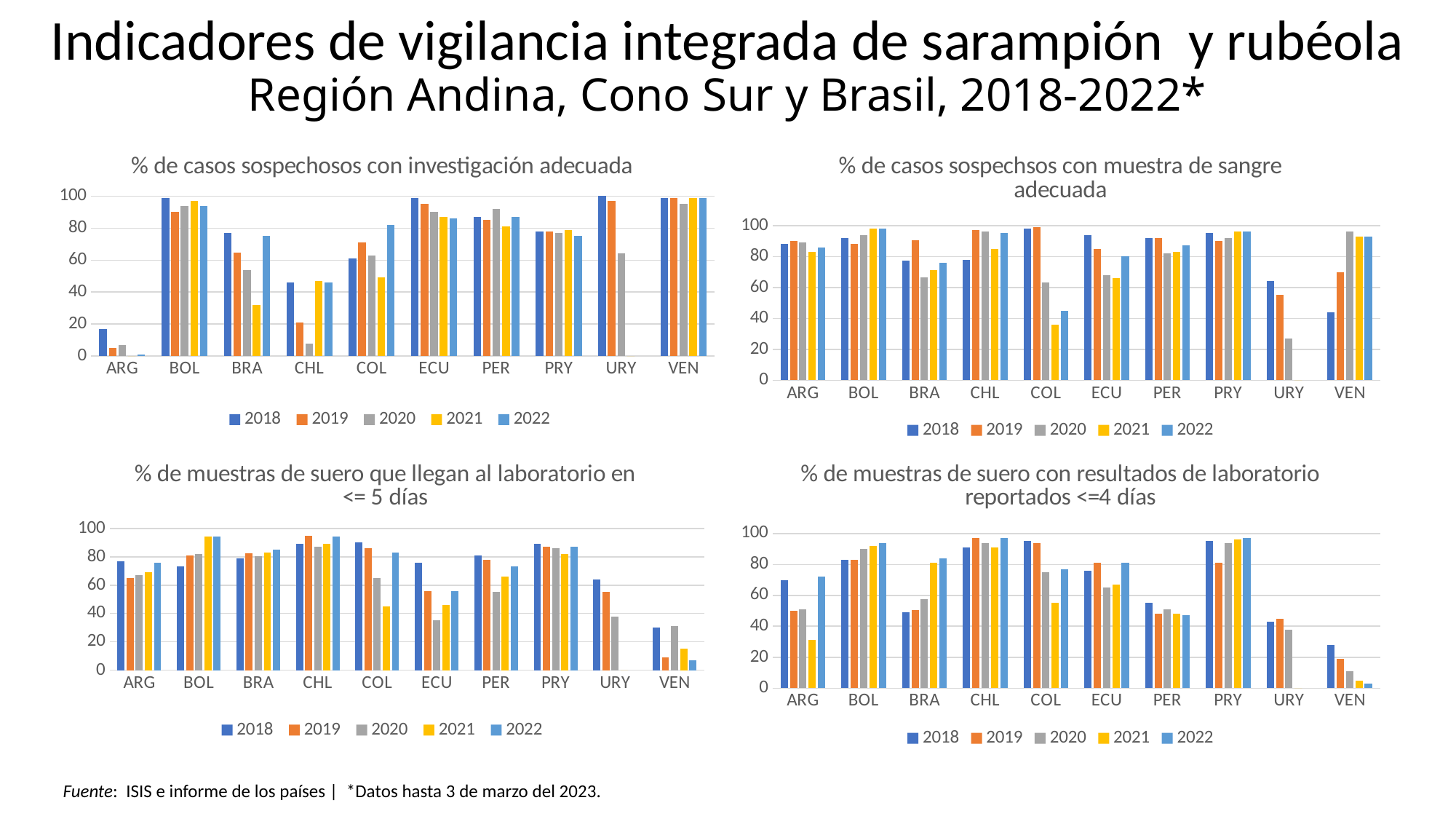
In the top-left chart '% de casos sospechosos con investigación adecuada', is the 2018 value for ARG greater or less than 20? less What years are listed in the legend of the bottom-right chart '% de muestras de suero con resultados de laboratorio reportados <=4 días'? 2018, 2019, 2020, 2021, 2022 In the bottom-right chart '% de muestras de suero con resultados de laboratorio reportados <=4 días', do the values for VEN rise or fall from 2018 to 2022? fall In the top-left chart '% de casos sospechosos con investigación adecuada', is the 2020 value for CHL greater or less than 20? less In the top-right chart '% de casos sospechsos con muestra de sangre adecuada', how many series does the legend list? 5 In the top-left chart '% de casos sospechosos con investigación adecuada', which is larger for BRA: the 2018 value or the 2021 value? 2018 In the bottom-left chart '% de muestras de suero que llegan al laboratorio en <= 5 días', which country has the lowest 2022 value? VEN In the top-right chart '% de casos sospechsos con muestra de sangre adecuada', is the 2020 value for URY greater or less than 40? less What kind of chart is the top-left chart titled '% de casos sospechosos con investigación adecuada'? bar chart In the top-left chart '% de casos sospechosos con investigación adecuada', how many countries are shown on the x axis? 10